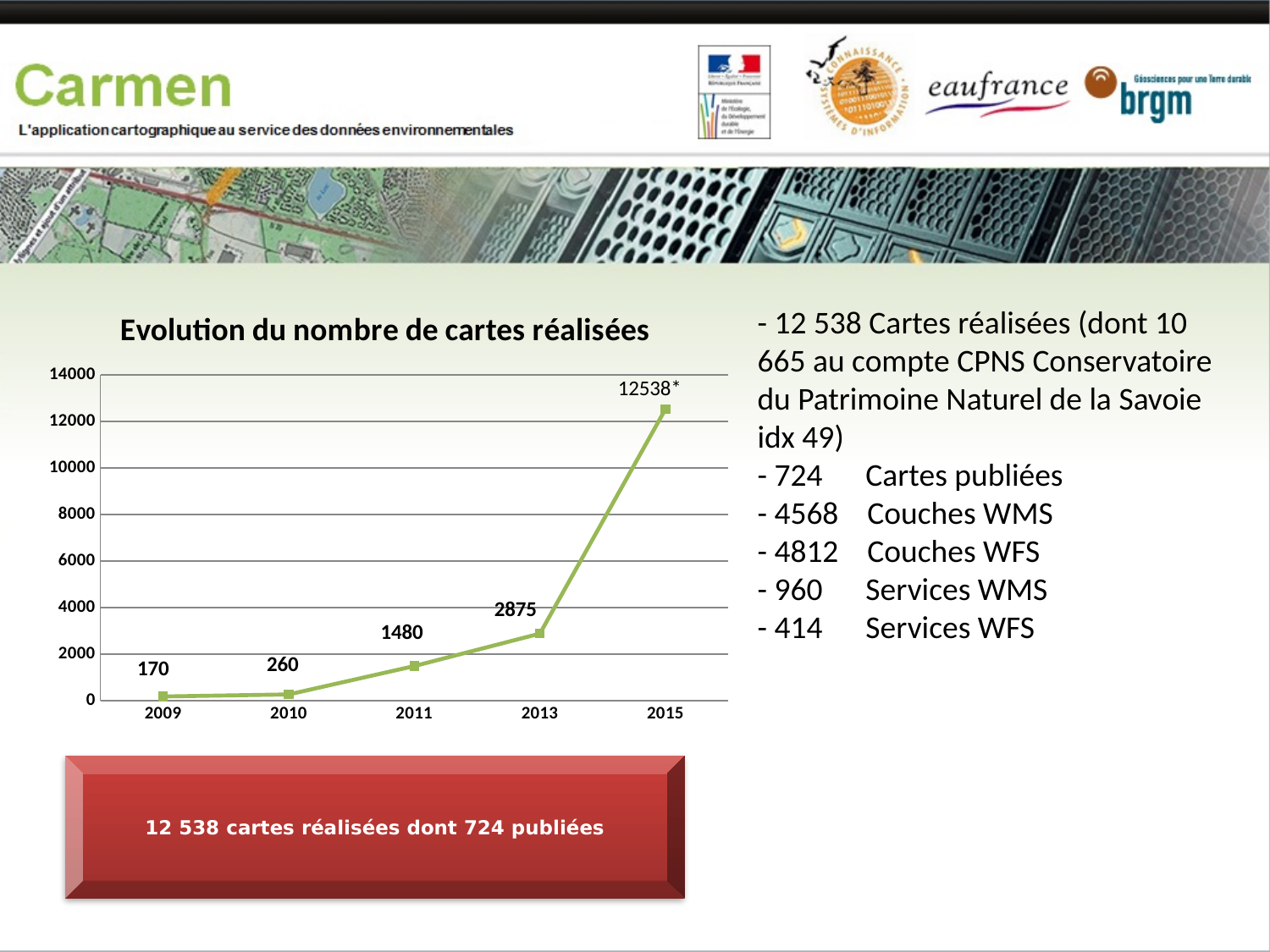
What is the value for 2015 in the chart? 12538 What kind of chart is shown on the slide? line chart What is the value for 2011 in the chart? 1480 Which is larger, the value for 2010 or the value for 2011? 2011 What is the value for 2013 in the chart? 2875 What is the value for 2009 in the chart? 170 What is the title of the chart? Evolution du nombre de cartes réalisées Do the values rise or fall from 2009 to 2015 in the chart? rise Which year has the lowest value in the chart? 2009 How many years are plotted on the x axis of the chart? 5 Which year has the highest value in the chart? 2015 What is the difference between the values for 2013 and 2011? 1395